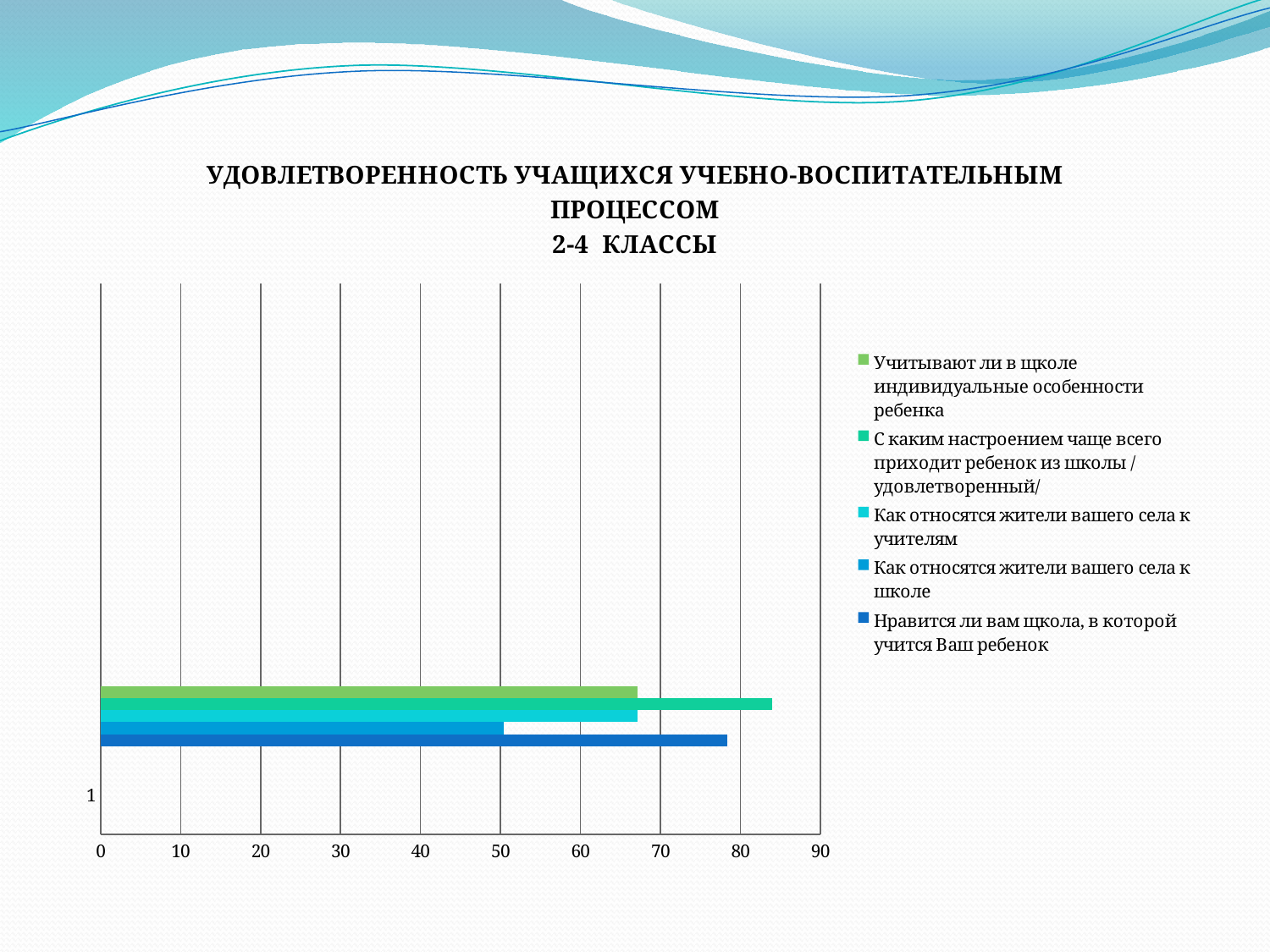
How many categories are shown on the vertical axis of the chart? 1 What kind of chart is shown on the slide? bar chart Is the value for "Учитывают ли в школе индивидуальные особенности ребенка" greater or less than 60? greater Which classes does the chart title refer to? 2-4 классы Is the value for "Нравится ли вам школа, в которой учится Ваш ребенок" greater or less than 70? greater Which is larger: the value for "Нравится ли вам школа, в которой учится Ваш ребенок" or the value for "Как относятся жители вашего села к школе"? Нравится ли вам школа, в которой учится Ваш ребенок How many series does the legend list? 5 Is the value for "С каким настроением чаще всего приходит ребенок из школы /удовлетворенный/" greater or less than 80? greater Which series has the longest bar? С каким настроением чаще всего приходит ребенок из школы /удовлетворенный/ What is the highest value shown on the horizontal axis? 90 Which series has the shortest bar? Как относятся жители вашего села к школе